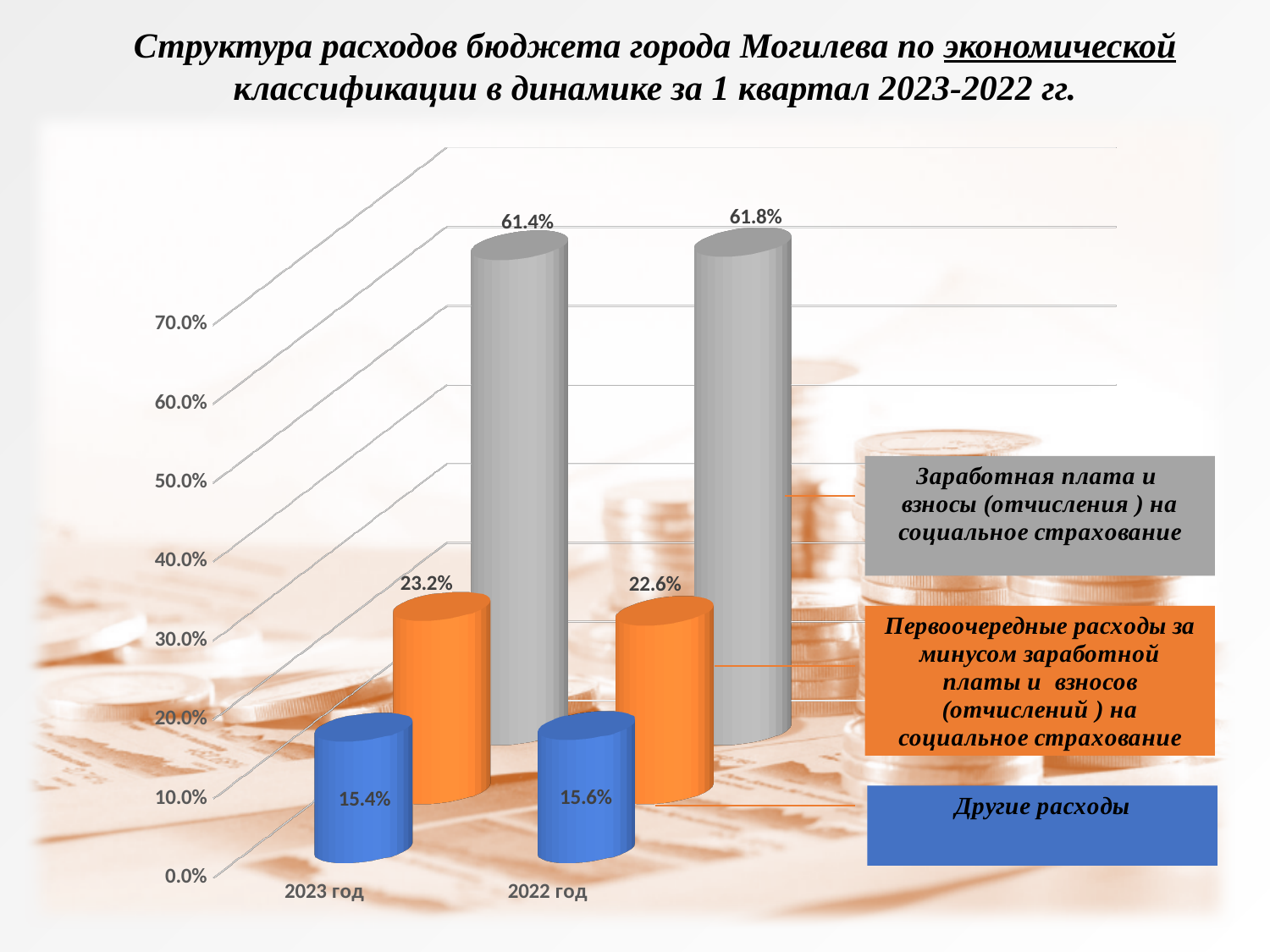
Is the value for "Заработная плата и взносы" in 2022 год greater or less than 60.0%? greater Which series has the lowest value in 2022 год? Другие расходы What is the value for "Первоочередные расходы за минусом заработной платы и взносов (отчислений ) на социальное страхование" in 2023 год? 23.2% What is the difference between the "Первоочередные расходы" values for 2023 год and 2022 год? 0.6% What kind of chart is shown on the slide? Bar chart How many series does the legend list? 3 Which series has the highest value in 2023 год? Заработная плата и взносы (отчисления ) на социальное страхование Which is larger: the "Другие расходы" value for 2023 год or for 2022 год? 2022 год How many year categories are shown on the x axis? 2 What is the value for "Заработная плата и взносы (отчисления ) на социальное страхование" in 2023 год? 61.4% What is the value for "Заработная плата и взносы (отчисления ) на социальное страхование" in 2022 год? 61.8% What is the value for "Другие расходы" in 2022 год? 15.6%